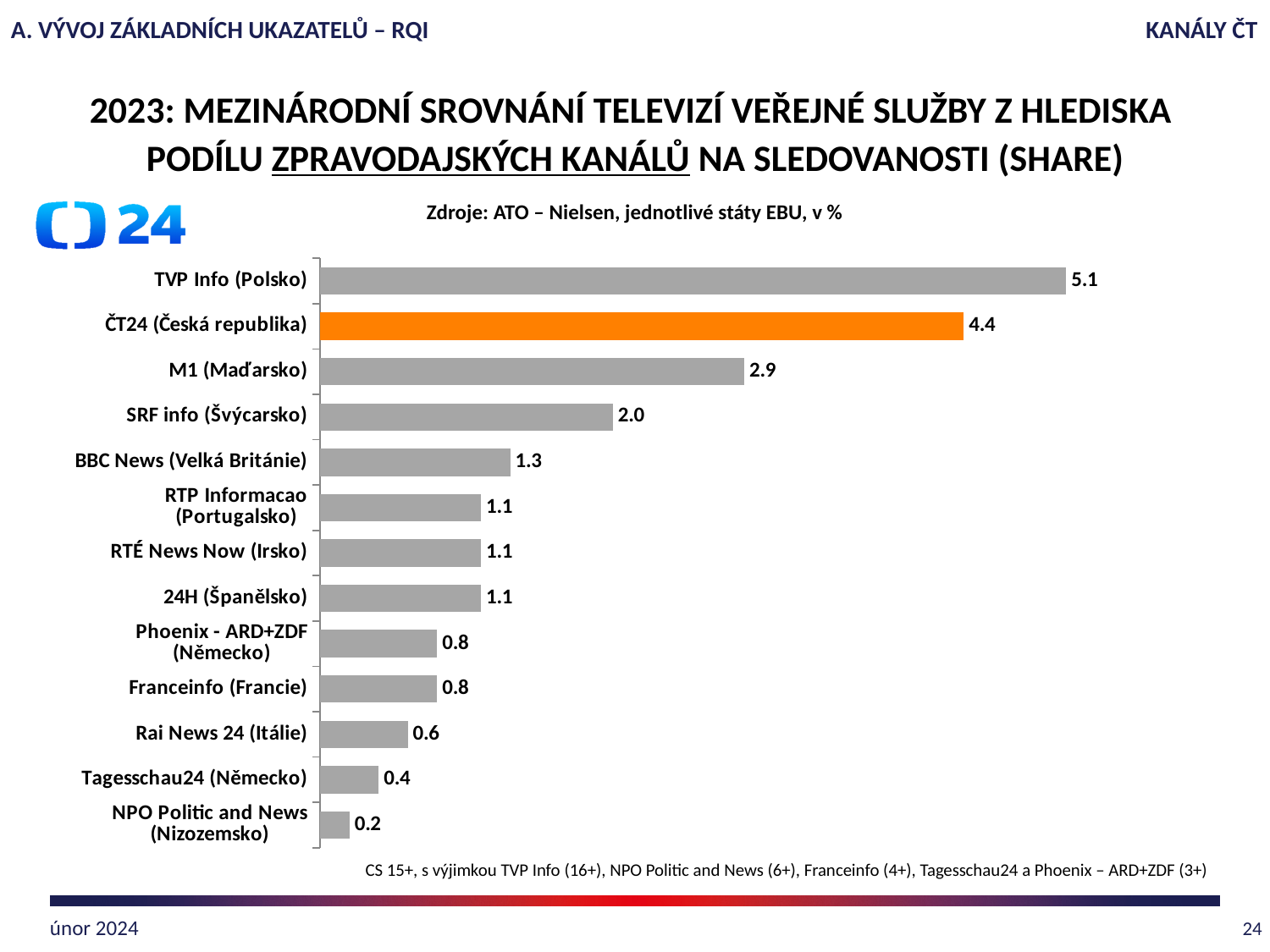
What is the value for ČT24 (Česká republika)? 4.4 How many channels are shown in the chart? 13 Which channel has the lowest share? NPO Politic and News (Nizozemsko) Which bar is highlighted in orange? ČT24 (Česká republika) What kind of chart is shown on the slide? bar chart What is the value for Tagesschau24 (Německo)? 0.4 Which is larger, the value for M1 (Maďarsko) or the value for SRF info (Švýcarsko)? M1 (Maďarsko) What is the difference between the values for TVP Info (Polsko) and ČT24 (Česká republika)? 0.7 What is the value for TVP Info (Polsko)? 5.1 Which channel has the highest share? TVP Info (Polsko) What is the value for SRF info (Švýcarsko)? 2.0 What is the difference between the values for M1 (Maďarsko) and BBC News (Velká Británie)? 1.6